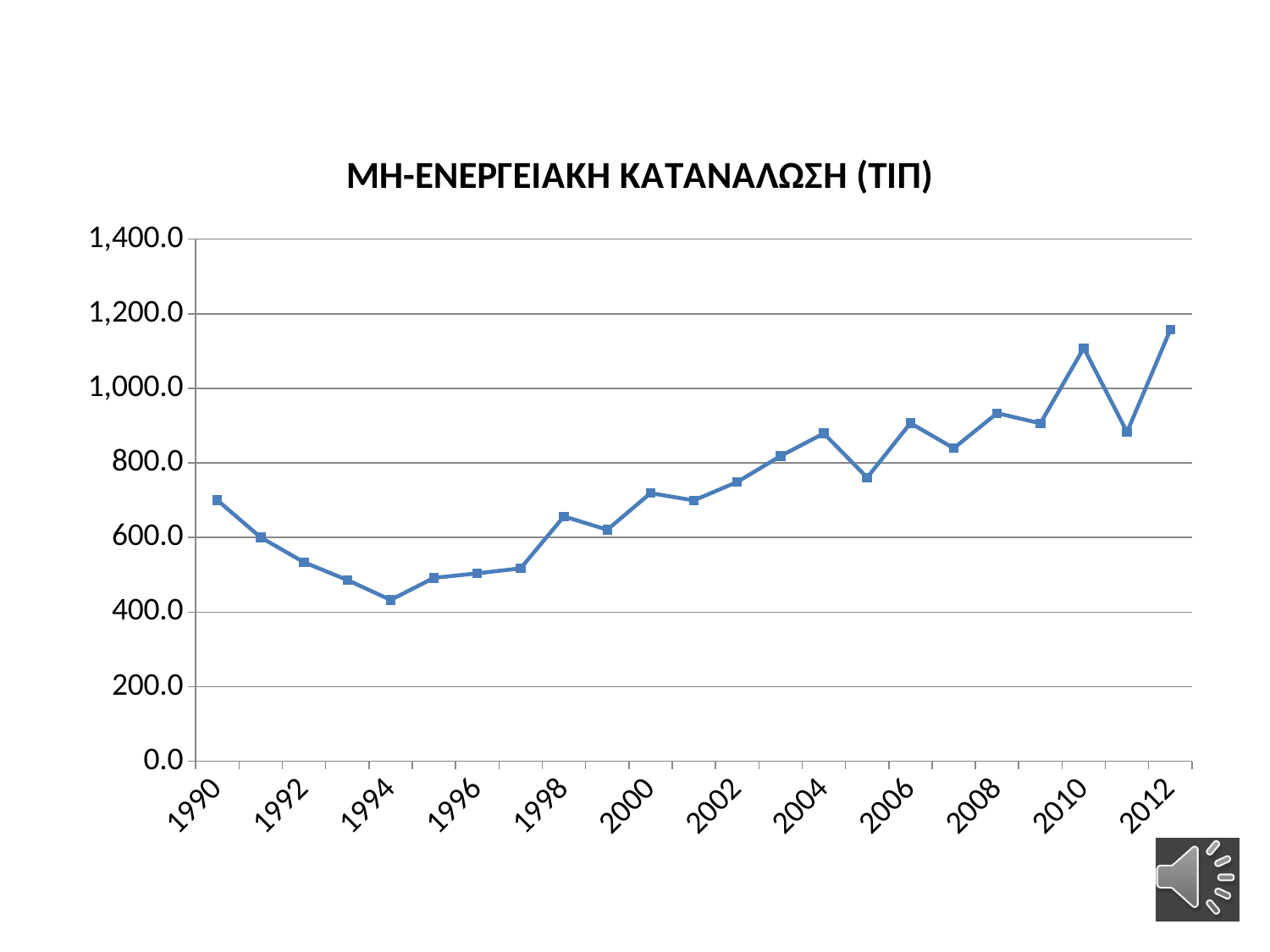
Is the value for 2010 greater or less than 1,000.0? greater Which year has the lowest value? 1994 Which year has the larger value, 2010 or 2011? 2010 Which year has the larger value, 1990 or 1994? 1990 Which year has the highest value? 2012 What is the title of the chart? ΜΗ-ΕΝΕΡΓΕΙΑΚΗ ΚΑΤΑΝΑΛΩΣΗ (ΤΙΠ) Is the value for 1994 greater or less than 600.0? less Is the value for 2005 greater or less than 800.0? less What kind of chart is shown on the slide? line chart Do the values rise or fall from 1990 to 1994? fall How many data points are plotted on the line? 23